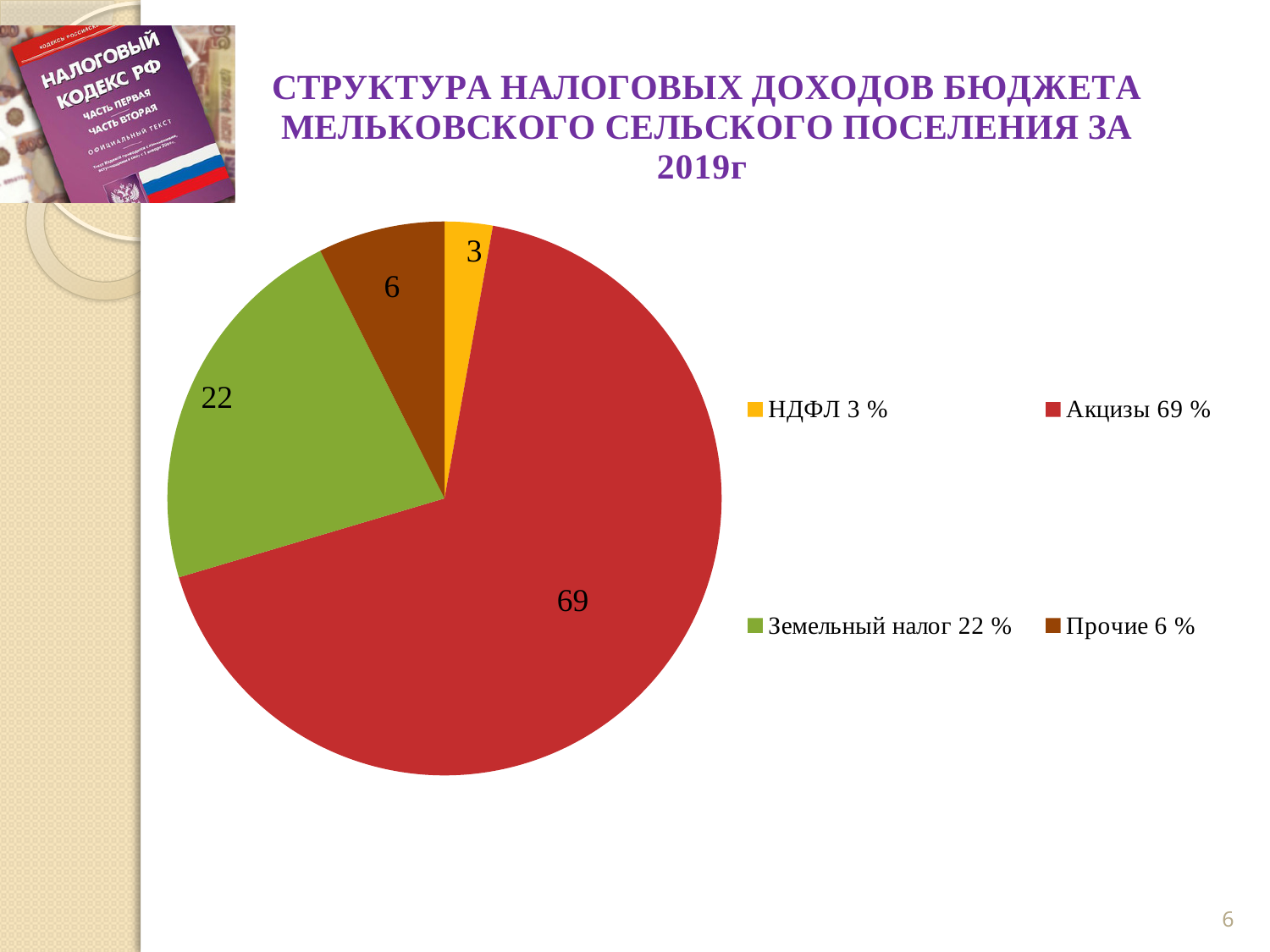
What is the value shown for Прочие? 6 What is the value shown for Земельный налог? 22 What is the value shown for НДФЛ? 3 What kind of chart is shown on the slide? pie chart What is the difference between the values for Акцизы and Земельный налог? 47 Which category has the smallest slice of the pie? НДФЛ What colour is the slice for Акцизы? red What is the value shown for Акцизы? 69 Which category has the largest slice of the pie? Акцизы What share of the pie does Земельный налог represent? 22 % Which is larger, the value for Прочие or the value for НДФЛ? Прочие How many slices does the pie chart have? 4